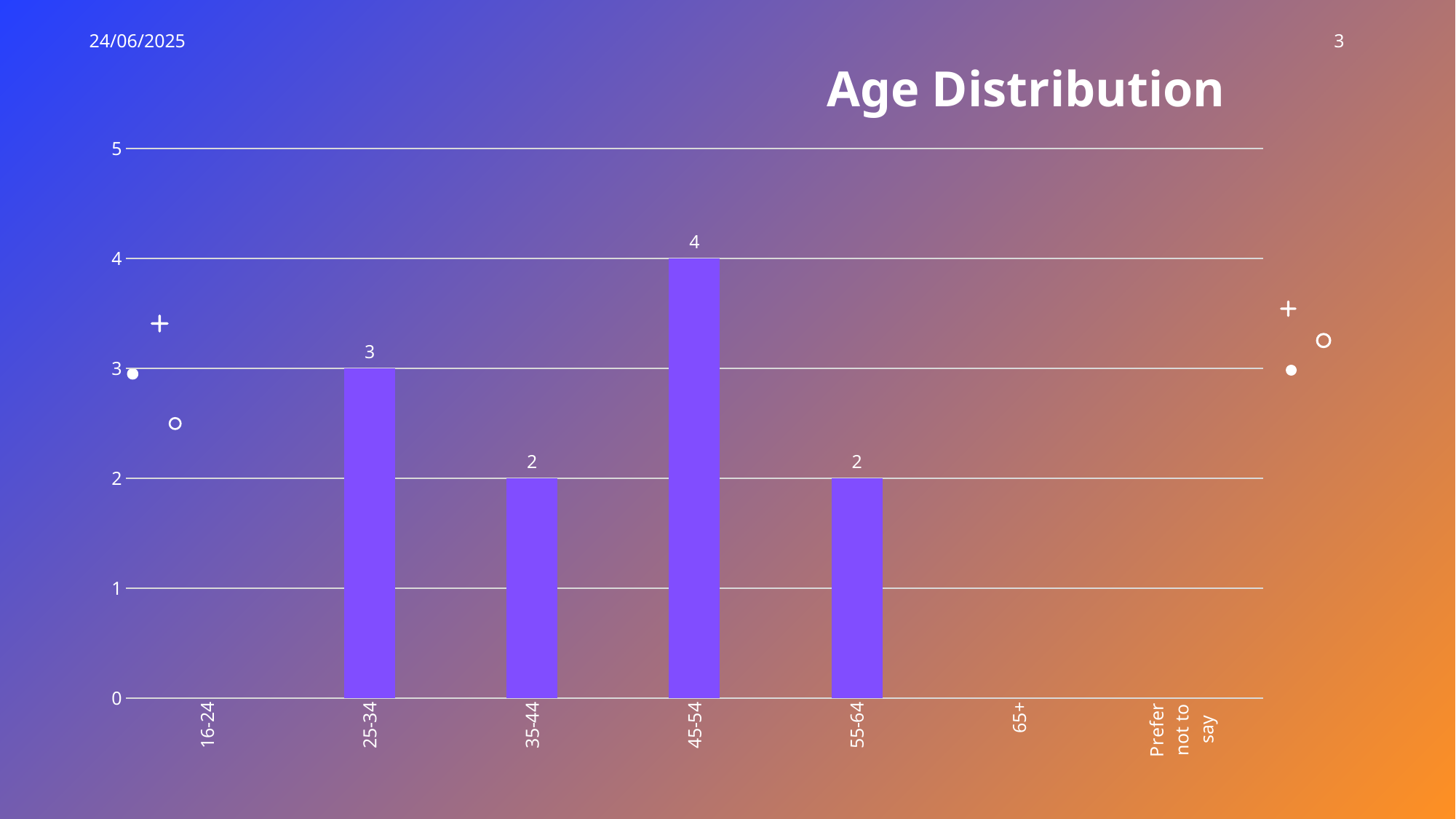
Which is larger, the value for 25-34 or the value for 55-64? 25-34 What is the value for the 25-34 age group? 3 What kind of chart is shown on the slide? bar chart What is the value for the 55-64 age group? 2 What is the difference between the values for 25-34 and 35-44? 1 What is the value for the 45-54 age group? 4 What is the value for the 35-44 age group? 2 What is the title of the chart? Age Distribution Which age group has the highest value? 45-54 How many categories are shown on the x axis? 7 What is the difference between the values for 45-54 and 25-34? 1 What is the total of the values for 25-34, 35-44, 45-54 and 55-64? 11